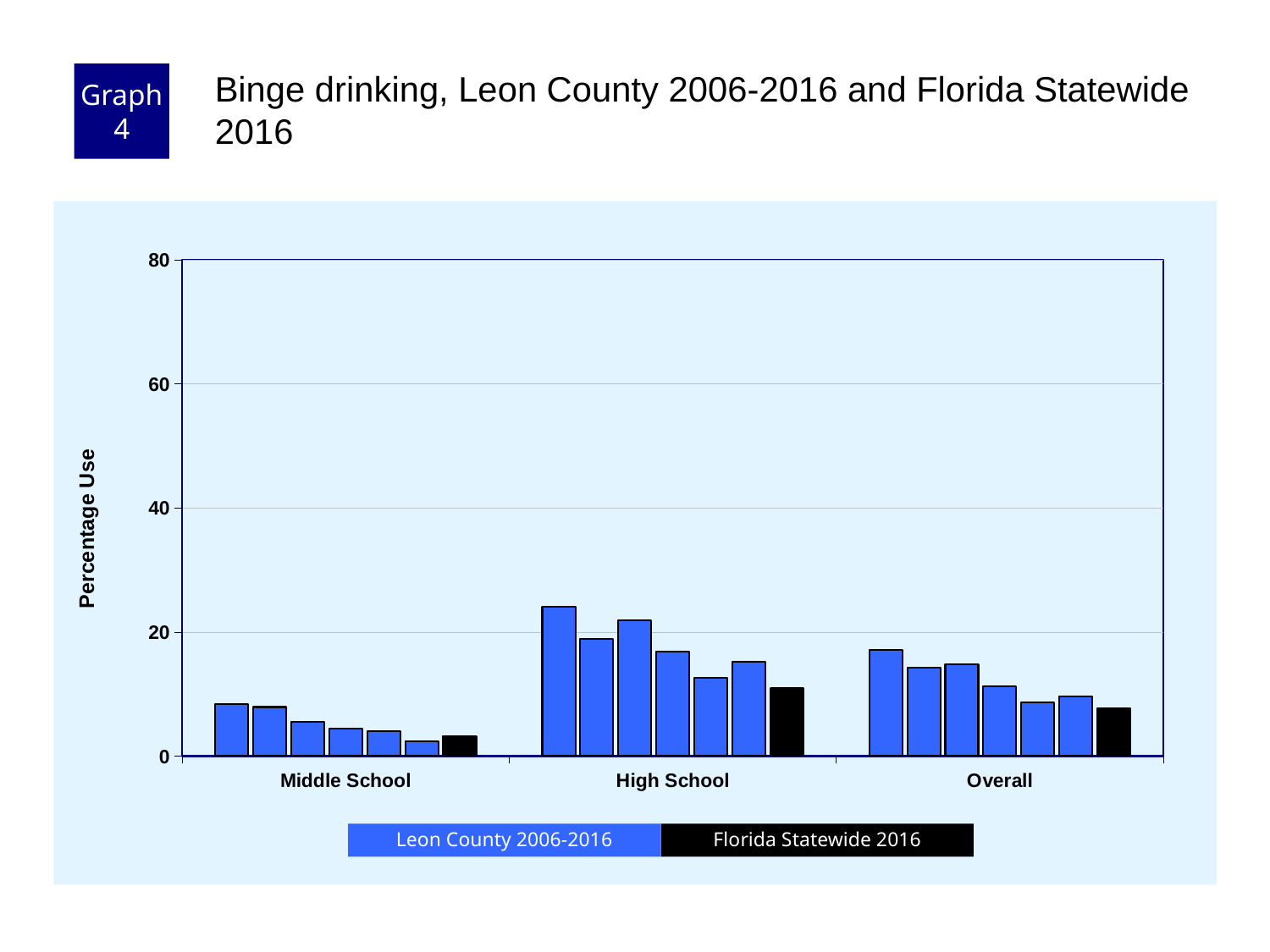
Do the Leon County 2006-2016 bars in the Middle School category generally rise or fall from left to right? fall How many series does the legend list? 2 What is the label on the y axis? Percentage Use Which category has the highest bars overall? High School What kind of chart is shown on the slide? bar chart In the High School category, is the Florida Statewide 2016 bar larger or smaller than the first Leon County bar? smaller Is the tallest Leon County bar in the High School category greater or less than 20? greater What colour are the Florida Statewide 2016 bars? black How many categories are shown on the x axis? 3 Is the value for Florida Statewide 2016 in the High School category greater or less than 20? less Which category has the lowest bars overall? Middle School Is the value for Florida Statewide 2016 in the Middle School category greater or less than 20? less